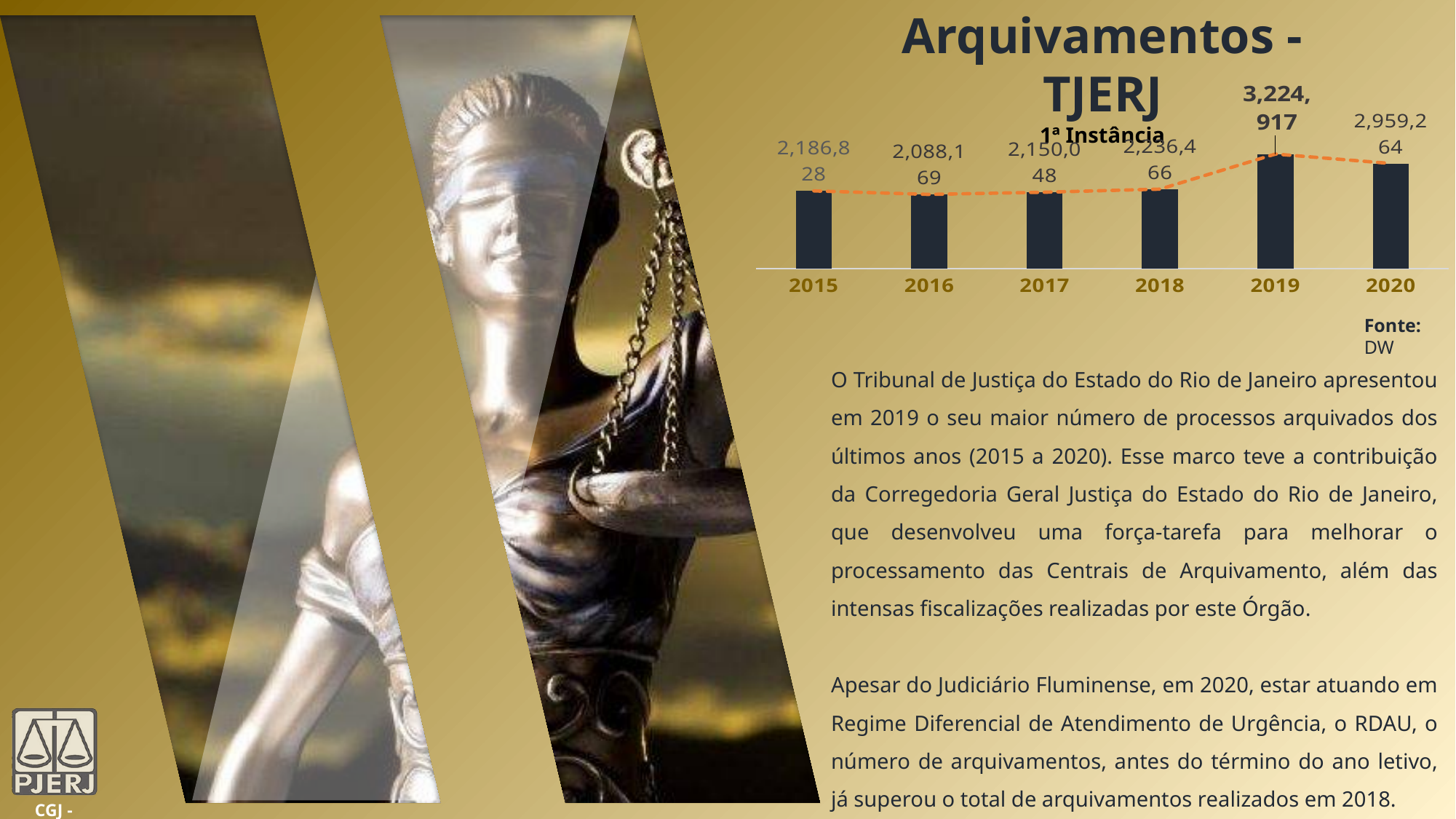
What is the value for 2019 in the Arquivamentos - TJERJ chart? 3,224,917 In the Arquivamentos - TJERJ chart, which is larger, the value for 2017 or the value for 2016? 2017 Which year has the lowest value in the Arquivamentos - TJERJ chart? 2016 What is the source cited below the Arquivamentos - TJERJ chart? DW What is the value for 2015 in the Arquivamentos - TJERJ chart? 2,186,828 What is the difference between the 2020 and 2018 values in the Arquivamentos - TJERJ chart? 722,798 What is the value for 2020 in the Arquivamentos - TJERJ chart? 2,959,264 What is the difference between the 2019 and 2018 values in the Arquivamentos - TJERJ chart? 988,451 What is the value for 2018 in the Arquivamentos - TJERJ chart? 2,236,466 Which year has the highest value in the Arquivamentos - TJERJ chart? 2019 What kind of chart is the Arquivamentos - TJERJ chart? Combination bar and line chart How many years are shown on the x axis of the Arquivamentos - TJERJ chart? 6